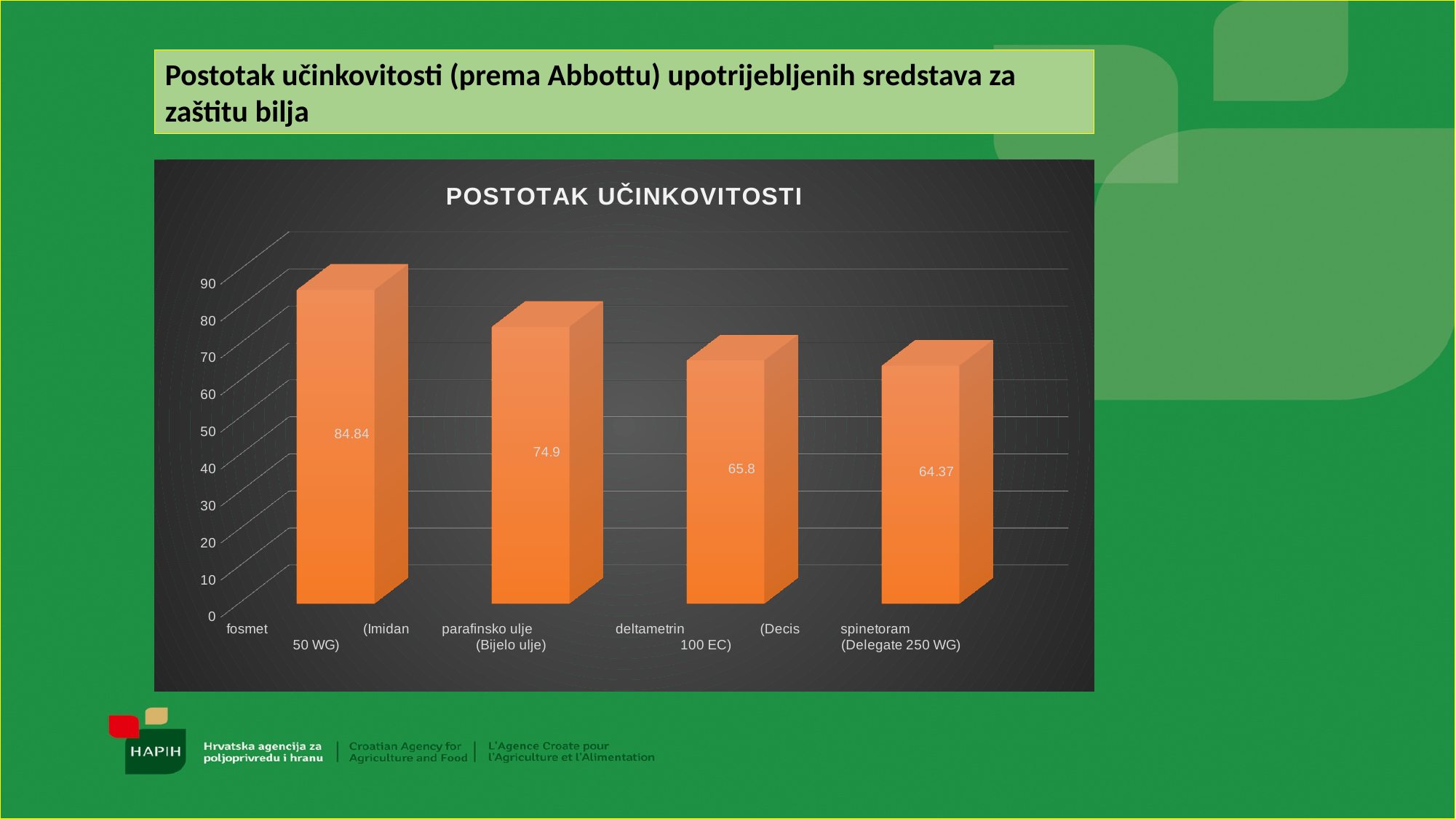
What is the value for deltametrin (Decis 100 EC)? 65.8 What is the title of the chart? POSTOTAK UČINKOVITOSTI What is the value for spinetoram (Delegate 250 WG)? 64.37 What is the difference between the values for fosmet (Imidan 50 WG) and parafinsko ulje (Bijelo ulje)? 9.94 Which is larger, the value for parafinsko ulje (Bijelo ulje) or the value for deltametrin (Decis 100 EC)? parafinsko ulje (Bijelo ulje) How many categories are shown in the chart? 4 What is the difference between the values for deltametrin (Decis 100 EC) and spinetoram (Delegate 250 WG)? 1.43 Which category has the highest value? fosmet (Imidan 50 WG) What kind of chart is shown on the slide? bar chart Which category has the lowest value? spinetoram (Delegate 250 WG) What is the value for fosmet (Imidan 50 WG)? 84.84 What is the value for parafinsko ulje (Bijelo ulje)? 74.9